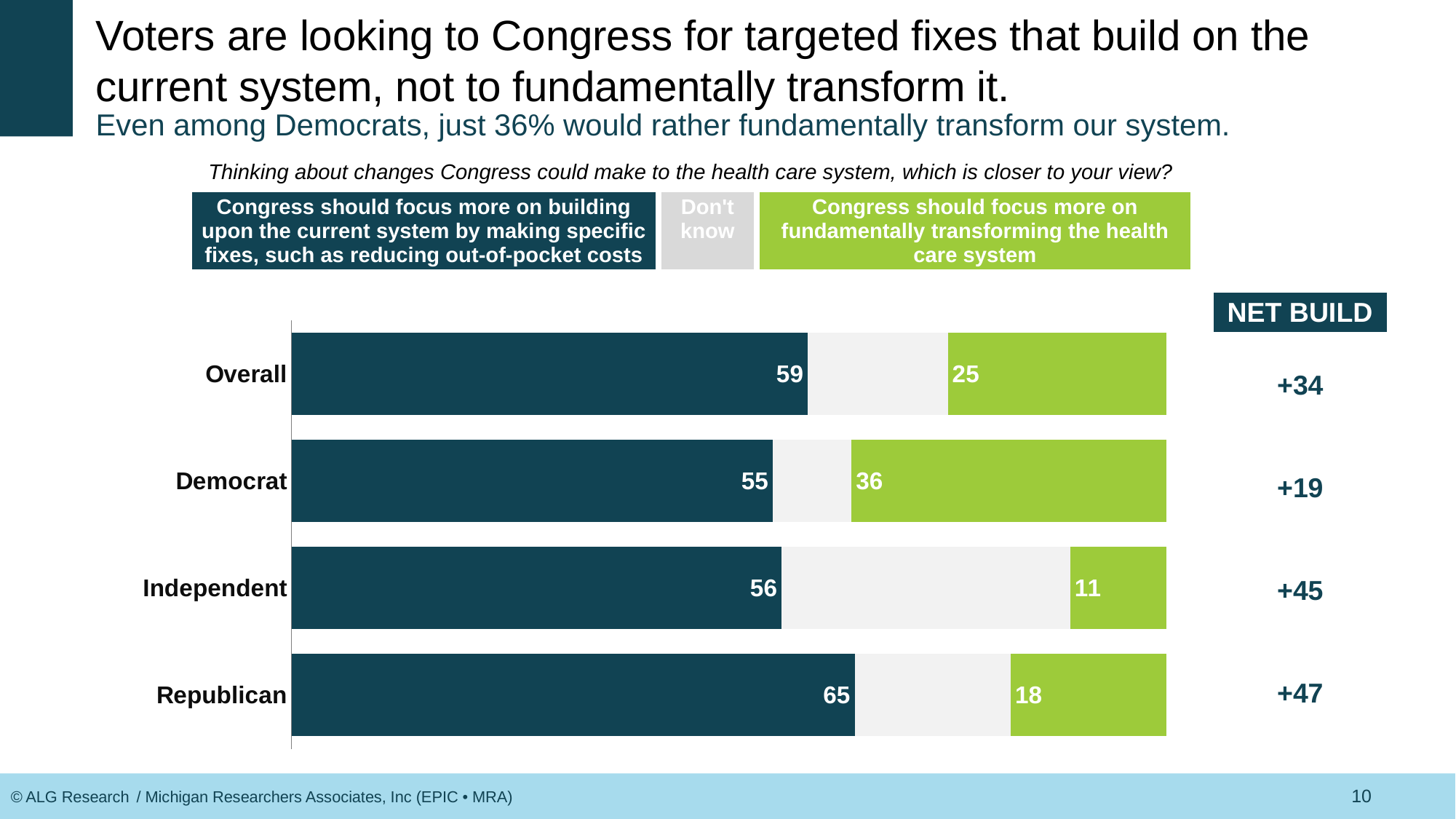
Which group has the lowest NET BUILD figure? Democrat What percentage of Republicans say Congress should focus more on building upon the current system? 65 What kind of chart is shown on the slide? Stacked bar chart What is the Overall value for focusing on building upon the current system? 59 What is the NET BUILD figure shown for Independents? +45 Which group has the lowest value for fundamentally transforming the health care system? Independent Which group has the highest value for building upon the current system? Republican What is the difference between the Republican and Democrat values for building upon the current system? 10 How many groups are shown on the chart? 4 How many response options does the legend list? 3 What percentage of Democrats say Congress should focus more on fundamentally transforming the health care system? 36 Which is larger: the Democrat value for fundamentally transforming the system or the Overall value for fundamentally transforming the system? Democrat